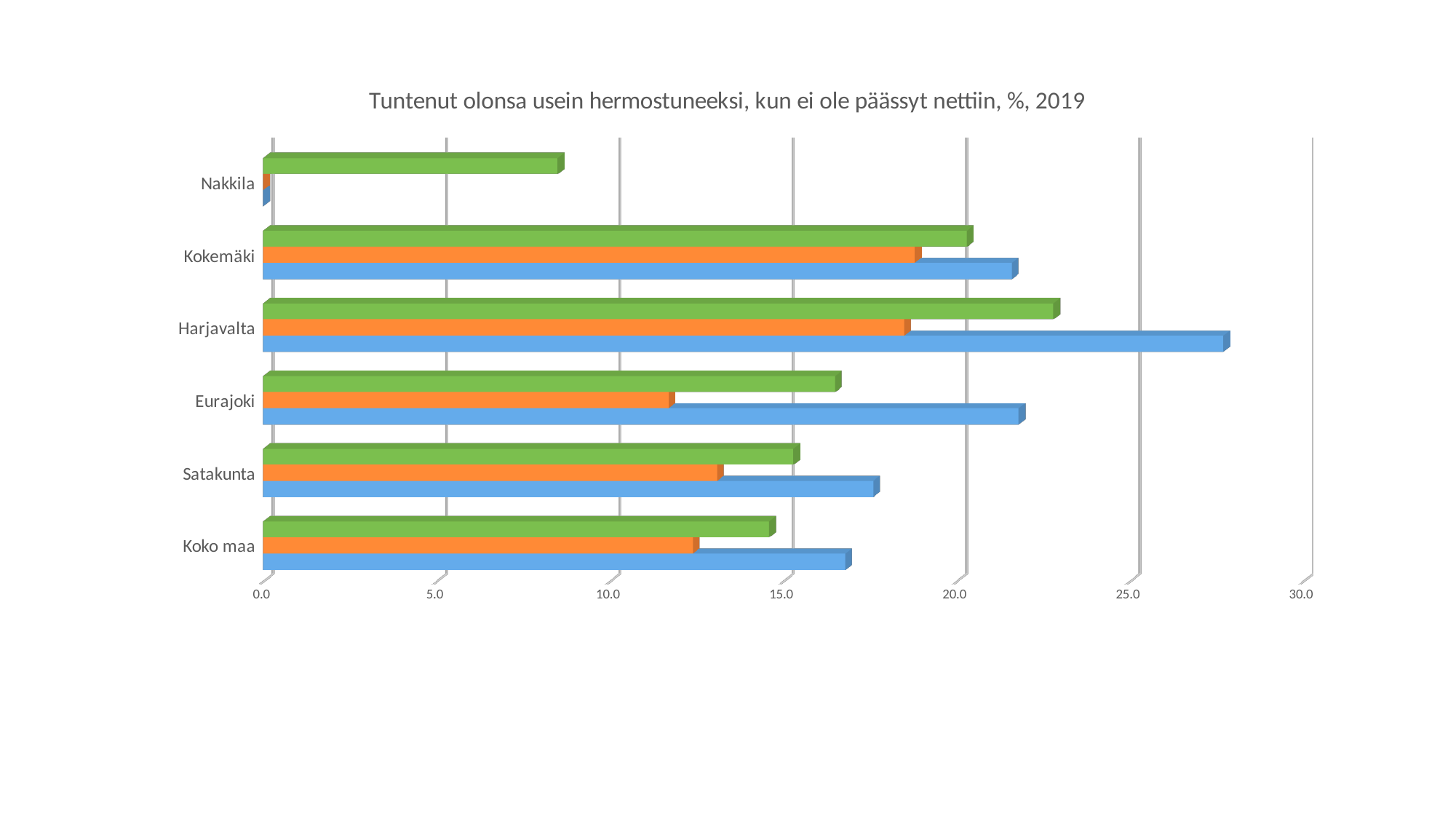
Which category has the longest green bar? Harjavalta Is the blue bar for Harjavalta greater or less than 25.0? greater How many differently coloured bars are shown for each category? 3 Is the blue bar for Kokemäki greater or less than 20.0? greater Is the green bar for Nakkila greater or less than 10.0? less What kind of chart is shown on the slide? Bar chart Which category has the shortest blue bar? Nakkila Which is larger, the blue bar for Eurajoki or the blue bar for Satakunta? Eurajoki Which category has the longest blue bar? Harjavalta What is the title of the chart? Tuntenut olonsa usein hermostuneeksi, kun ei ole päässyt nettiin, %, 2019 How many categories (areas) are shown on the vertical axis of the chart? 6